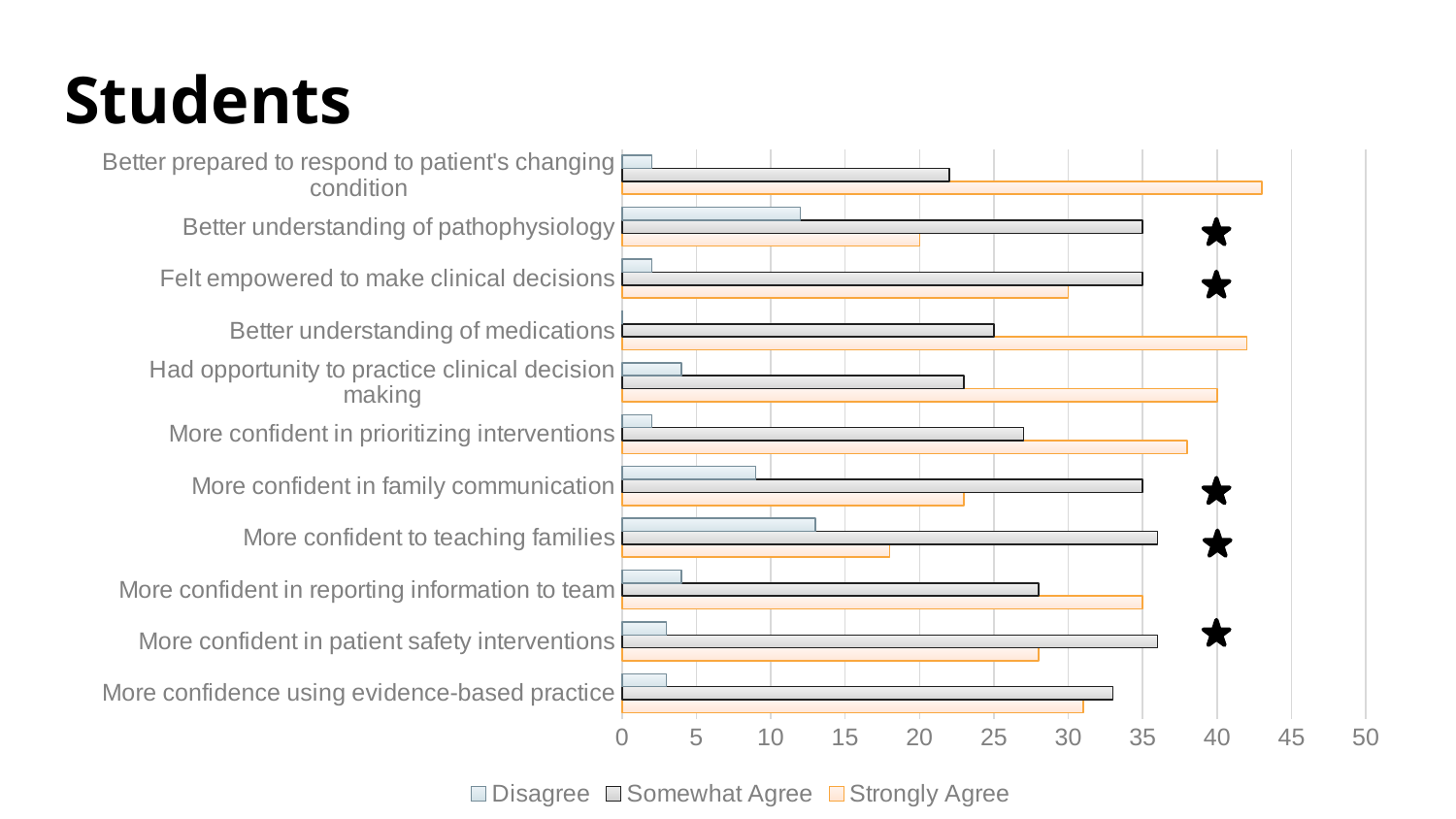
What are the three legend entries of the chart? Disagree, Somewhat Agree, Strongly Agree For 'Better understanding of medications', which is larger: Somewhat Agree or Strongly Agree? Strongly Agree What kind of chart is shown on the slide? bar chart For 'Better understanding of pathophysiology', which is larger: Somewhat Agree or Strongly Agree? Somewhat Agree How many categories are plotted on the chart? 11 How many series does the legend list? 3 Is the Somewhat Agree value for 'More confidence using evidence-based practice' greater or less than 30? greater What is the title of the slide containing the chart? Students Is the Disagree value for 'More confident to teaching families' greater or less than 10? greater Is the Strongly Agree value for 'More confident in prioritizing interventions' greater or less than 35? greater